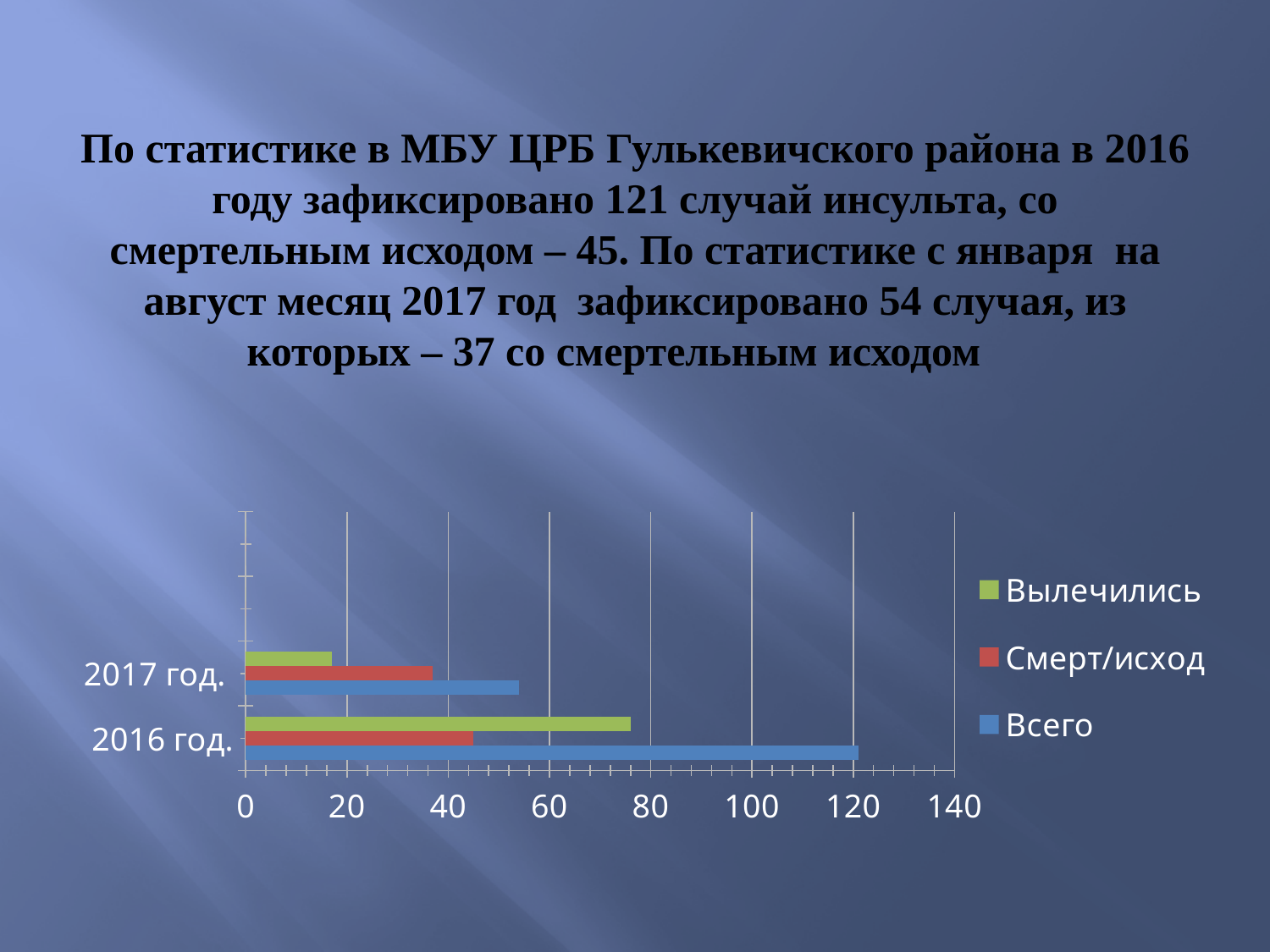
Is the value of Всего for 2016 год. greater or less than 100? greater How many year categories are shown on the chart's vertical axis? 2 Is the value of Вылечились for 2017 год. greater or less than 20? less Which series has the longest bar for 2016 год.? Всего How many series does the chart legend list? 3 Is the value of Всего for 2017 год. greater or less than 60? less Which year has the higher value for Всего, 2016 год. or 2017 год.? 2016 год. Which year has the lower value for Вылечились? 2017 год. What kind of chart is shown on the slide? bar chart What colour are the bars for the Смерт/исход series? red